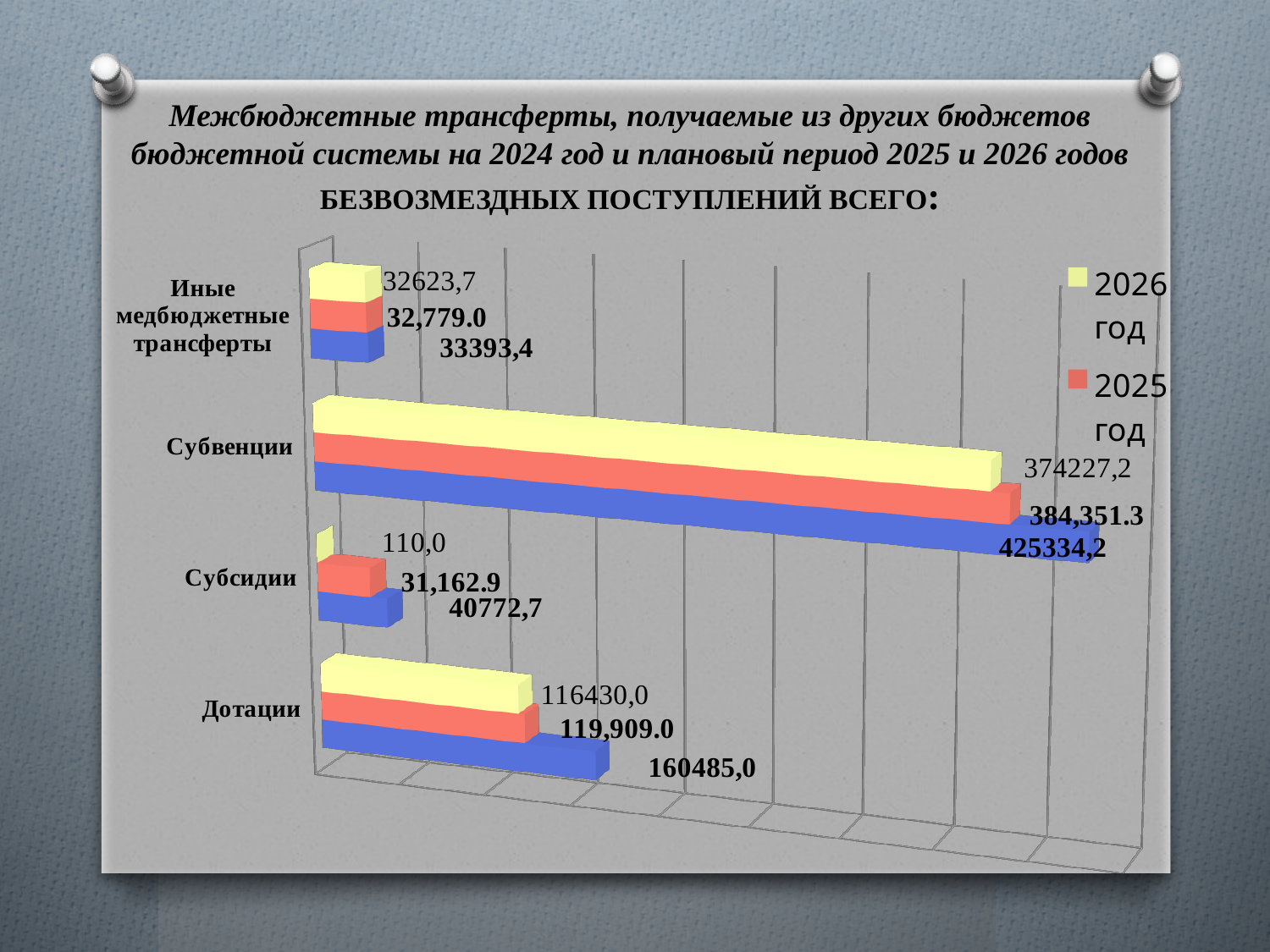
Which category has the highest 2026 год value? Субвенции What kind of chart is shown on the slide? Bar chart What is the 2025 год value for Субсидии? 31,162.9 Which is larger for Дотации: the 2025 год value or the 2026 год value? 2025 год What is the 2025 год value for Дотации? 119,909.0 How many categories are shown on the chart? 4 Which colour represents 2026 год in the legend? Yellow What is the difference between the blue bar value and the 2026 год value for Субвенции? 51107,0 What is the 2026 год value for Субсидии? 110,0 Which category has the lowest 2026 год value? Субсидии What is the 2026 год value for Субвенции? 374227,2 What is the value of the blue (bottom) bar for Иные медбюджетные трансферты? 33393,4